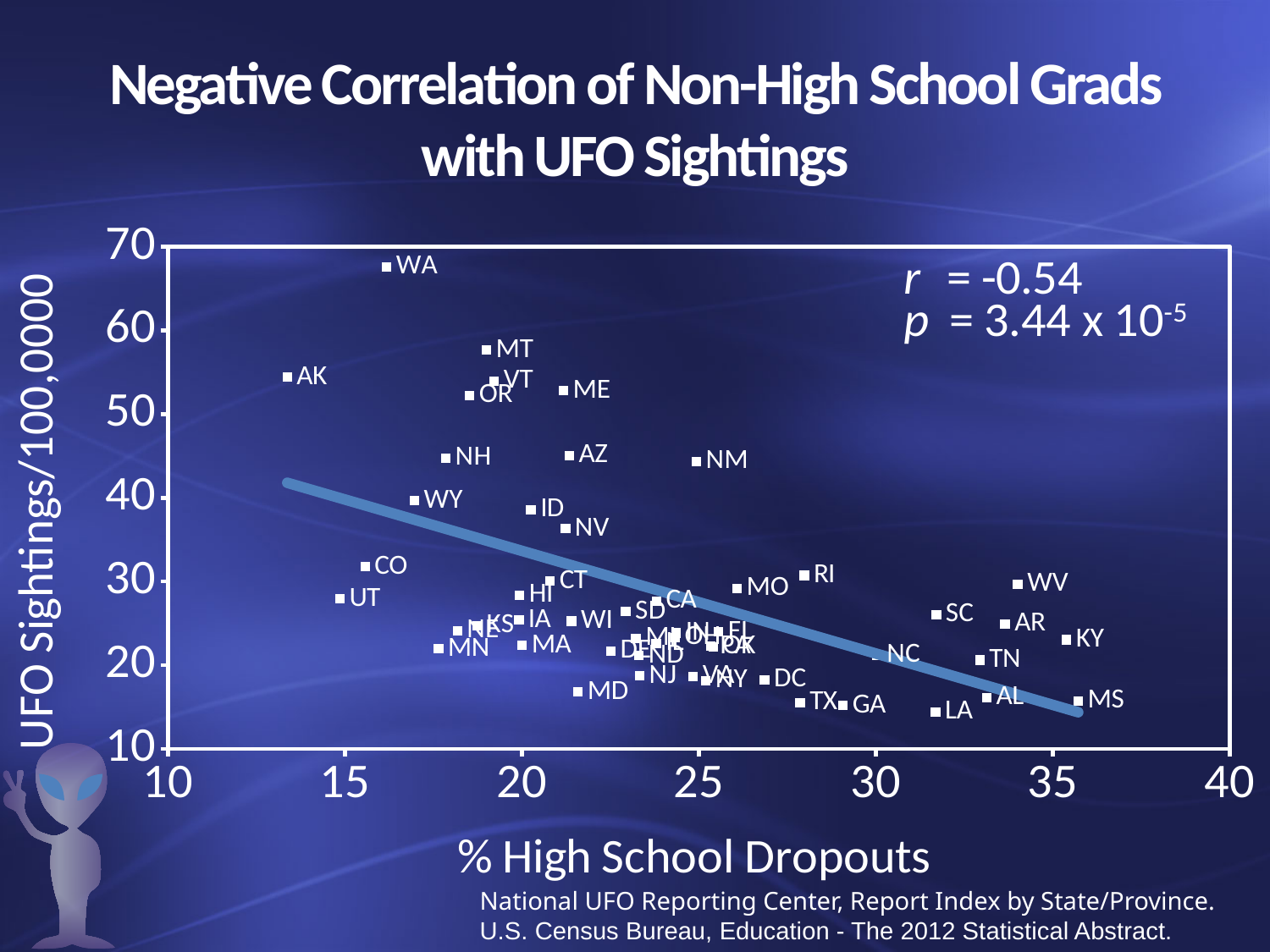
Is the UFO sightings value for WA greater or less than 60? greater Which has a higher UFO sightings value, MT or ME? MT Is the UFO sightings value for NM greater or less than 40? greater What is the correlation coefficient r shown on the chart? -0.54 Is the UFO sightings value for MD greater or less than 20? less Which state has the highest UFO sightings value on the chart? WA Which has a higher UFO sightings value, AK or MS? AK What is the label of the x axis? % High School Dropouts What kind of chart is shown on the slide? scatter plot Does the trend line show UFO sightings rising or falling as the percentage of high school dropouts increases? falling